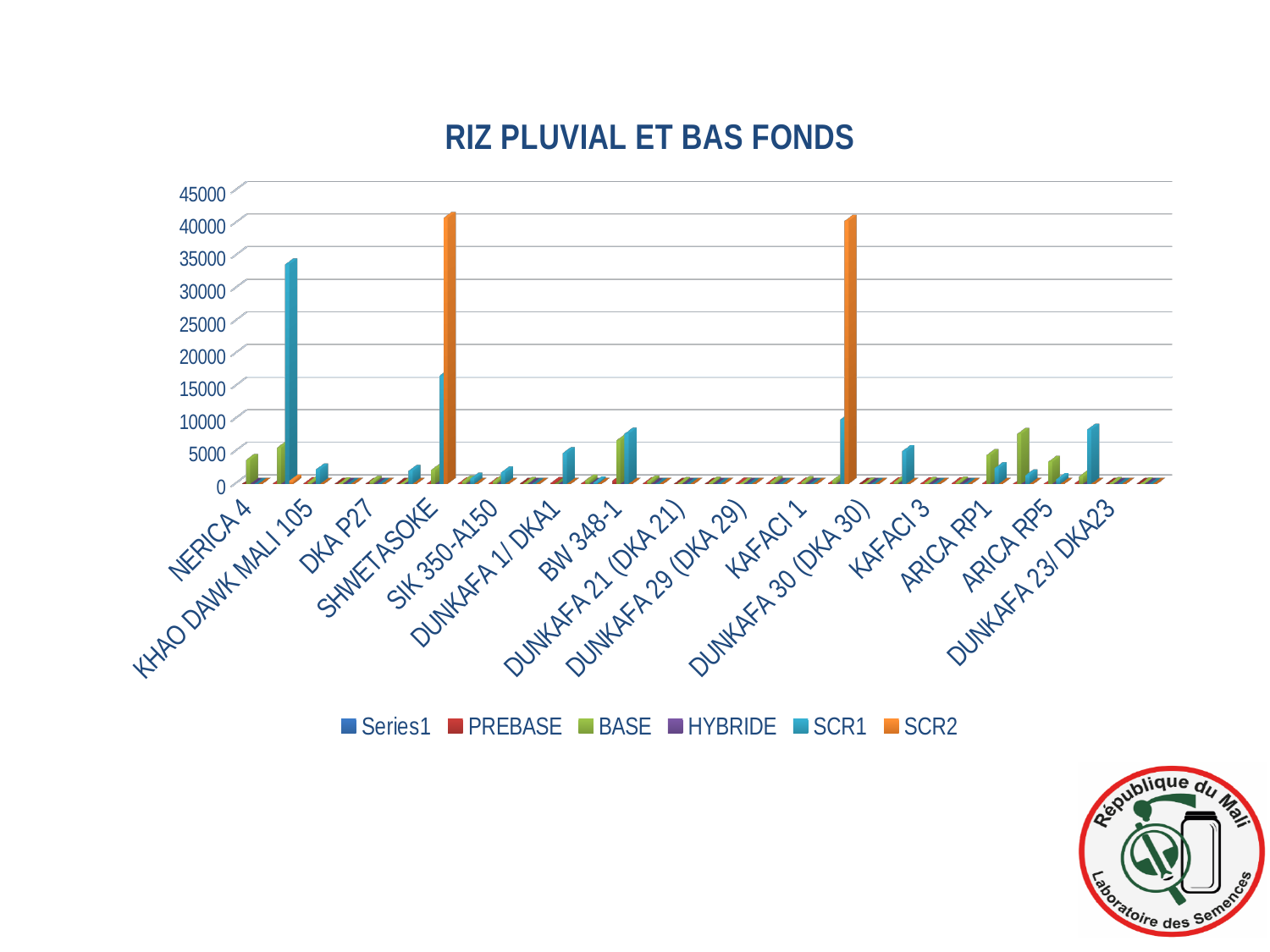
Is the SCR2 value for DUNKAFA 30 (DKA 30) greater or less than 35000? less Which is larger, the SCR1 value for KHAO DAWK MALI 105 or the SCR1 value for DUNKAFA 30 (DKA 30)? KHAO DAWK MALI 105 How many series does the legend list? 6 What kind of chart is shown on the slide? bar chart Which colour represents the SCR2 series in the legend? orange How many categories are shown on the x axis? 15 Is the SCR1 value for DUNKAFA 30 (DKA 30) greater or less than 15000? less Is the BASE value for ARICA RP5 greater or less than 10000? less What is the title of the chart? RIZ PLUVIAL ET BAS FONDS